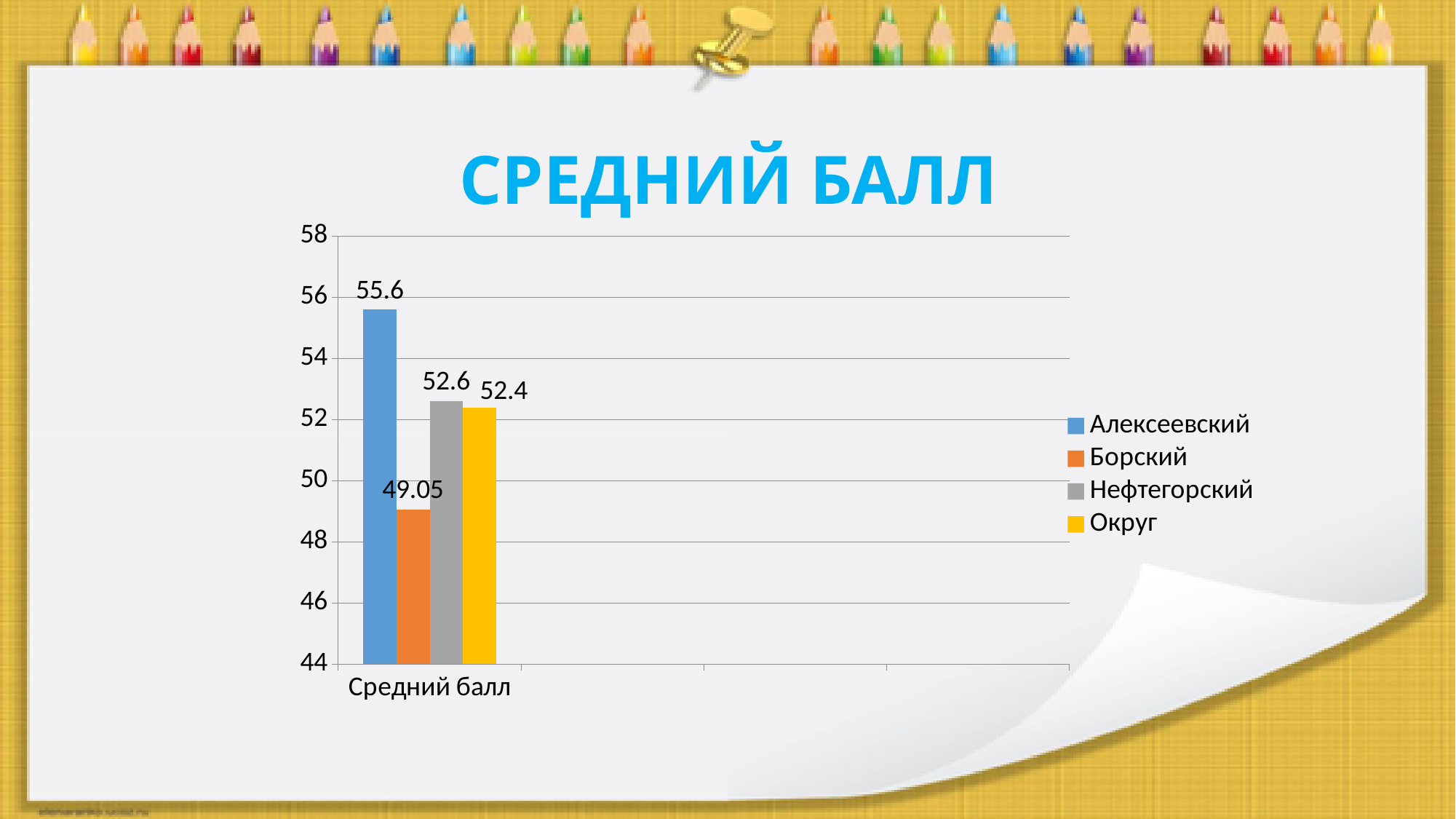
How many series does the legend list? 4 What is the difference between the values for Алексеевский and Борский? 6.55 What is the value for Борский? 49.05 What is the value for Алексеевский? 55.6 Which is larger, the value for Алексеевский or the value for Округ? Алексеевский What kind of chart is shown on the slide? bar chart Is the value for Борский greater or less than 50? less What is the value for Округ? 52.4 What is the value for Нефтегорский? 52.6 Which series has the lowest value? Борский What is the difference between the values for Нефтегорский and Округ? 0.2 Which series has the highest value? Алексеевский